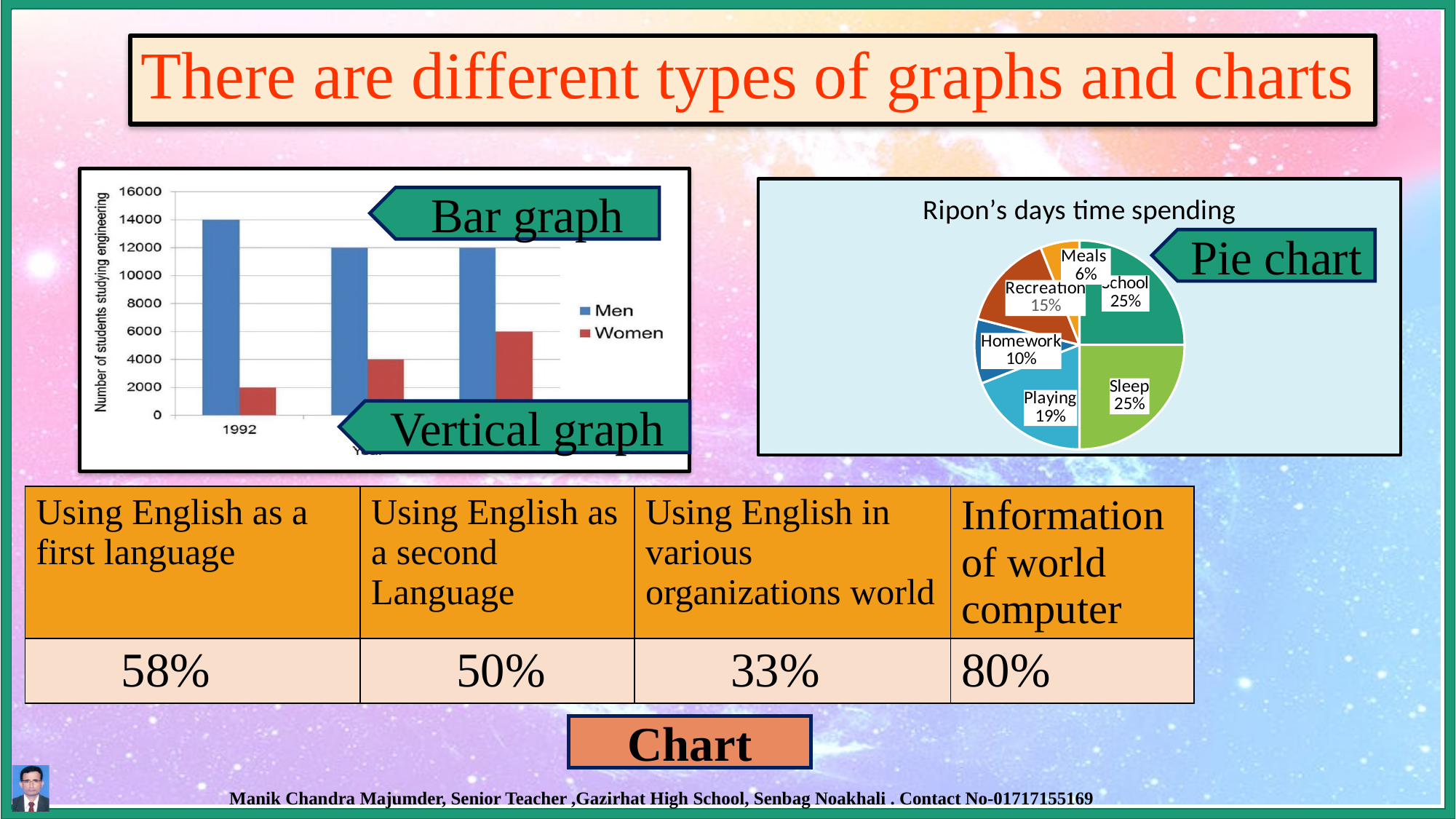
In the pie chart 'Ripon's days time spending', what is the value for Playing? 19% In the pie chart 'Ripon's days time spending', what is the difference between Recreation and Homework? 5% What is the title of the pie chart on the right? Ripon's days time spending In the bar chart on the left, how many series does the legend list? 2 In the pie chart 'Ripon's days time spending', which category has the smallest share? Meals In the pie chart 'Ripon's days time spending', what share is Sleep? 25% In the pie chart 'Ripon's days time spending', how many slices are there? 6 In the bar chart on the left, what is the value for Women in 1992? 2000 In the bar chart on the left, what is the value for Men in 1992? 14000 What type of chart is the chart on the left of the slide? bar chart In the bar chart on the left, which is larger in 1992, Men or Women? Men In the bar chart on the left, do the Women values rise or fall from left to right along the x axis? rise